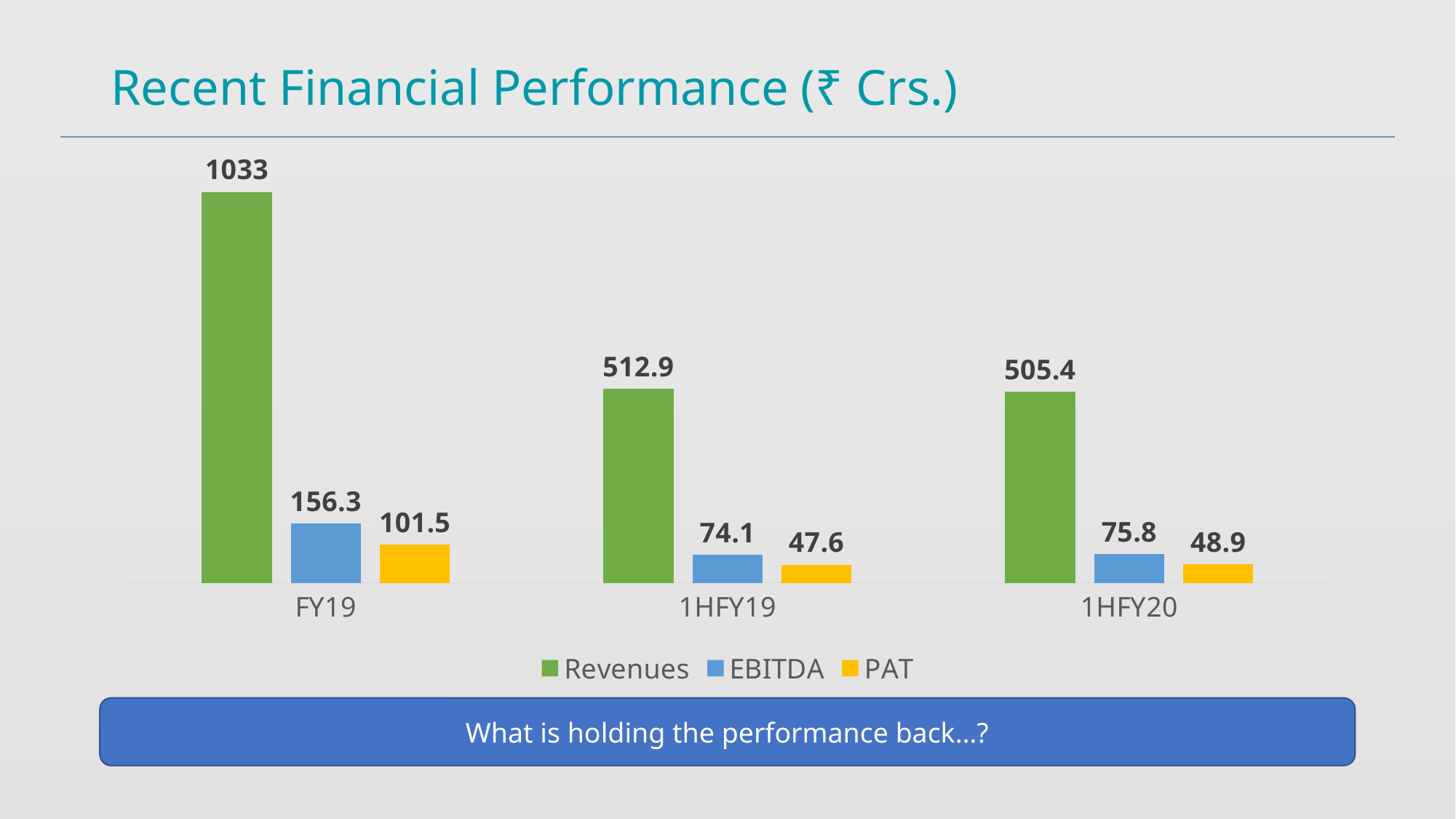
What is the EBITDA value for 1HFY20? 75.8 Which colour represents PAT in the chart? Yellow What is the PAT value for 1HFY19? 47.6 Which period has the highest Revenues? FY19 Which is larger, EBITDA in 1HFY19 or EBITDA in 1HFY20? EBITDA in 1HFY20 How many periods are shown on the x axis? 3 What is the Revenues value for FY19? 1033 How many series does the legend list? 3 What kind of chart is shown on the slide? Bar chart Which period has the lowest PAT? 1HFY19 What is the difference between Revenues in 1HFY19 and 1HFY20? 7.5 What is the difference between EBITDA and PAT in FY19? 54.8